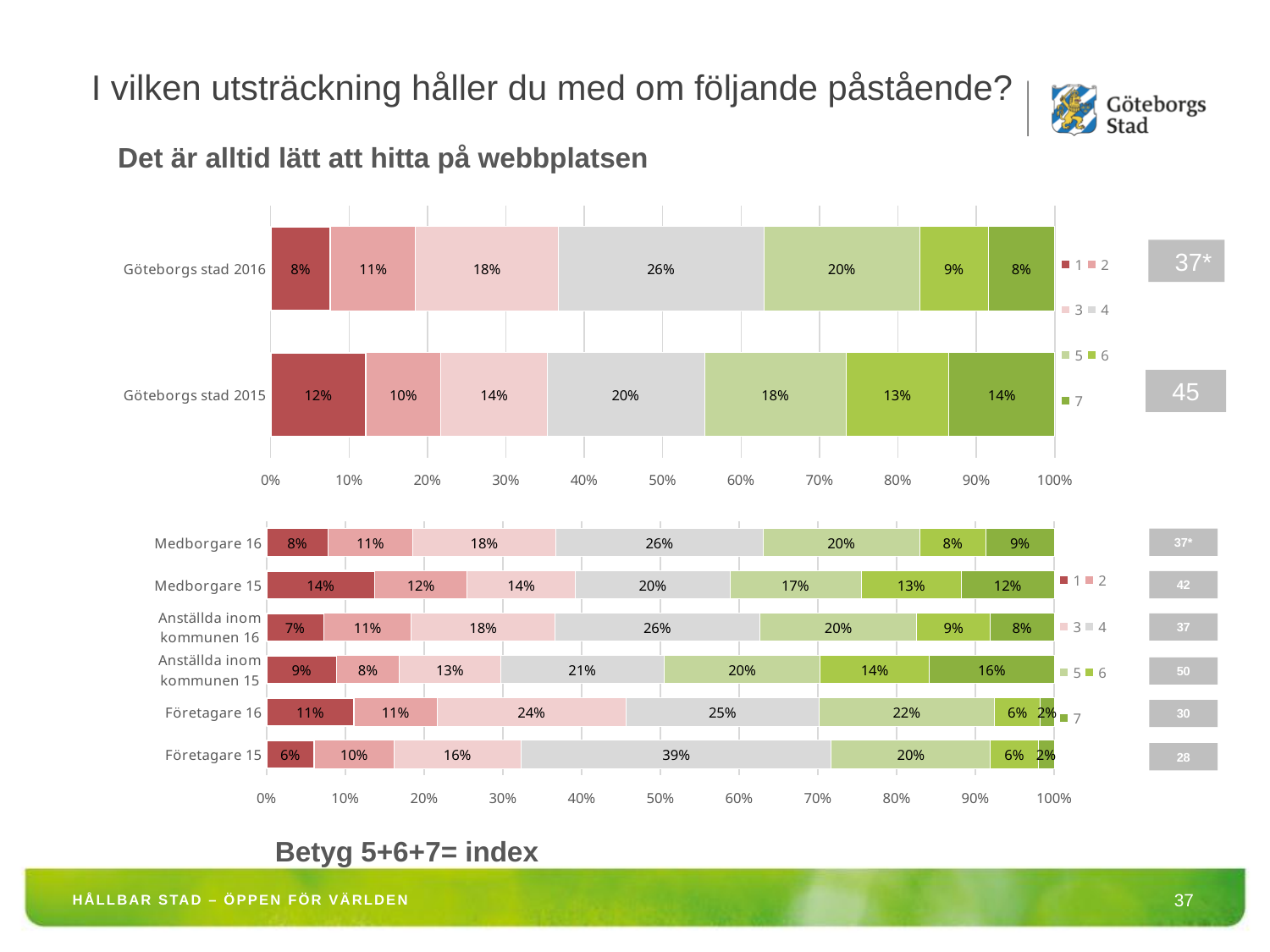
In the bottom chart, how many categories are plotted? 6 In the bottom chart, what is the value for rating 4 for Företagare 15? 39% In the bottom chart, what is the value for rating 5 for Företagare 16? 22% In the top chart, what is the value for rating 7 for Göteborgs stad 2015? 14% In the bottom chart, which has the larger rating 7 value: Anställda inom kommunen 15 or Medborgare 15? Anställda inom kommunen 15 In the top chart, what index value is shown to the right of the Göteborgs stad 2015 bar? 45 In the bottom chart, which category has the highest value for rating 4? Företagare 15 What kind of chart is the top chart? Stacked bar chart In the top chart, what is the difference between the rating 4 values for Göteborgs stad 2016 and Göteborgs stad 2015? 6 percentage points In the top chart, how many series does the legend list? 7 In the bottom chart, which category has the lowest value for rating 1? Företagare 15 In the top chart, what is the value for rating 4 for Göteborgs stad 2016? 26%